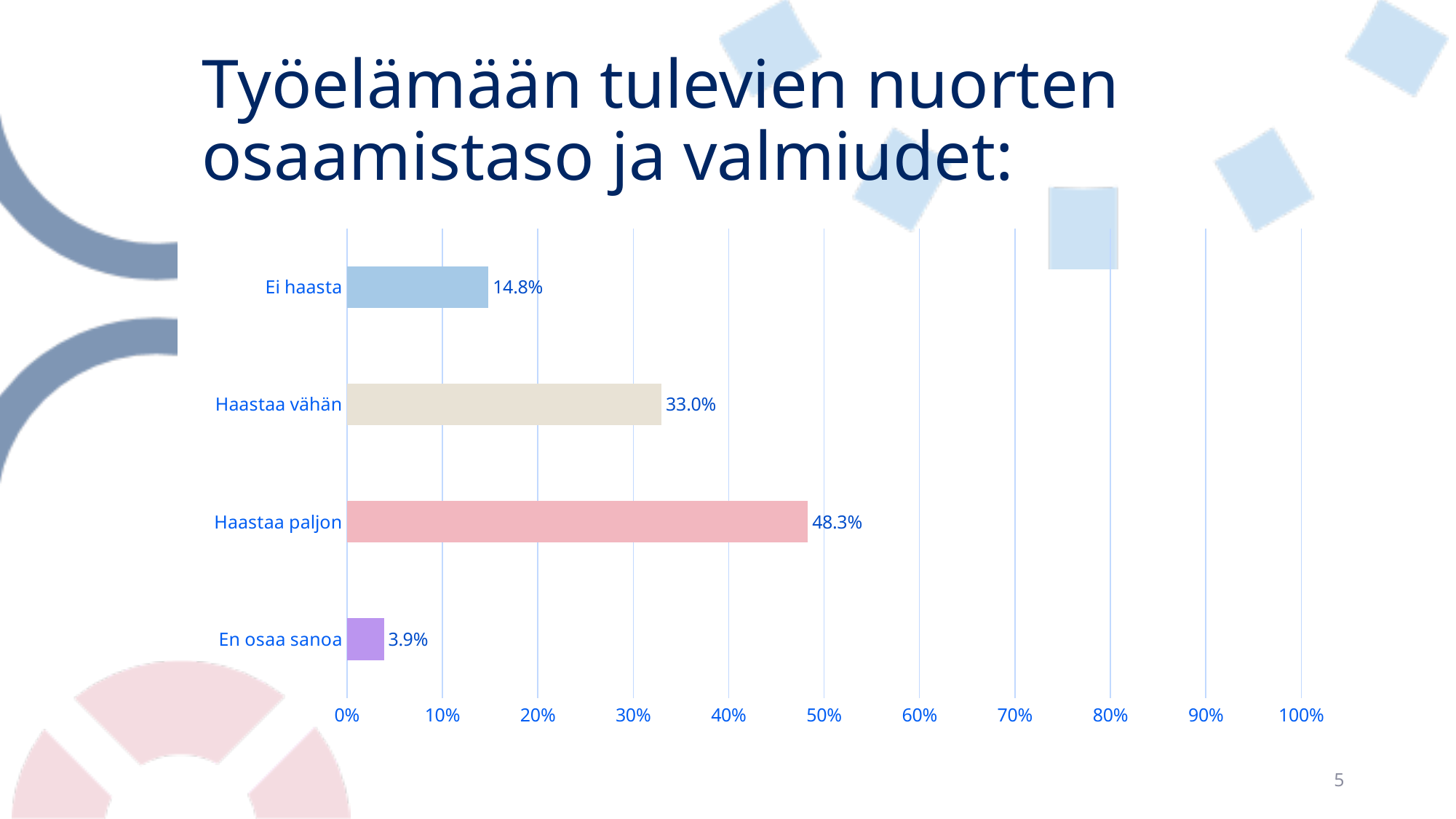
Which category has the highest value? Haastaa paljon What is the value for Haastaa vähän? 33.0% Which is larger, the value for Ei haasta or the value for Haastaa vähän? Haastaa vähän Which category has the lowest value? En osaa sanoa What is the maximum value shown on the horizontal axis? 100% What is the difference between the values for Haastaa paljon and Haastaa vähän? 15.3% What is the value for Ei haasta? 14.8% Is the value for Haastaa paljon greater or less than 40%? greater What kind of chart is shown on the slide? bar chart What is the value for Haastaa paljon? 48.3% What is the value for En osaa sanoa? 3.9% How many categories are shown in the chart? 4